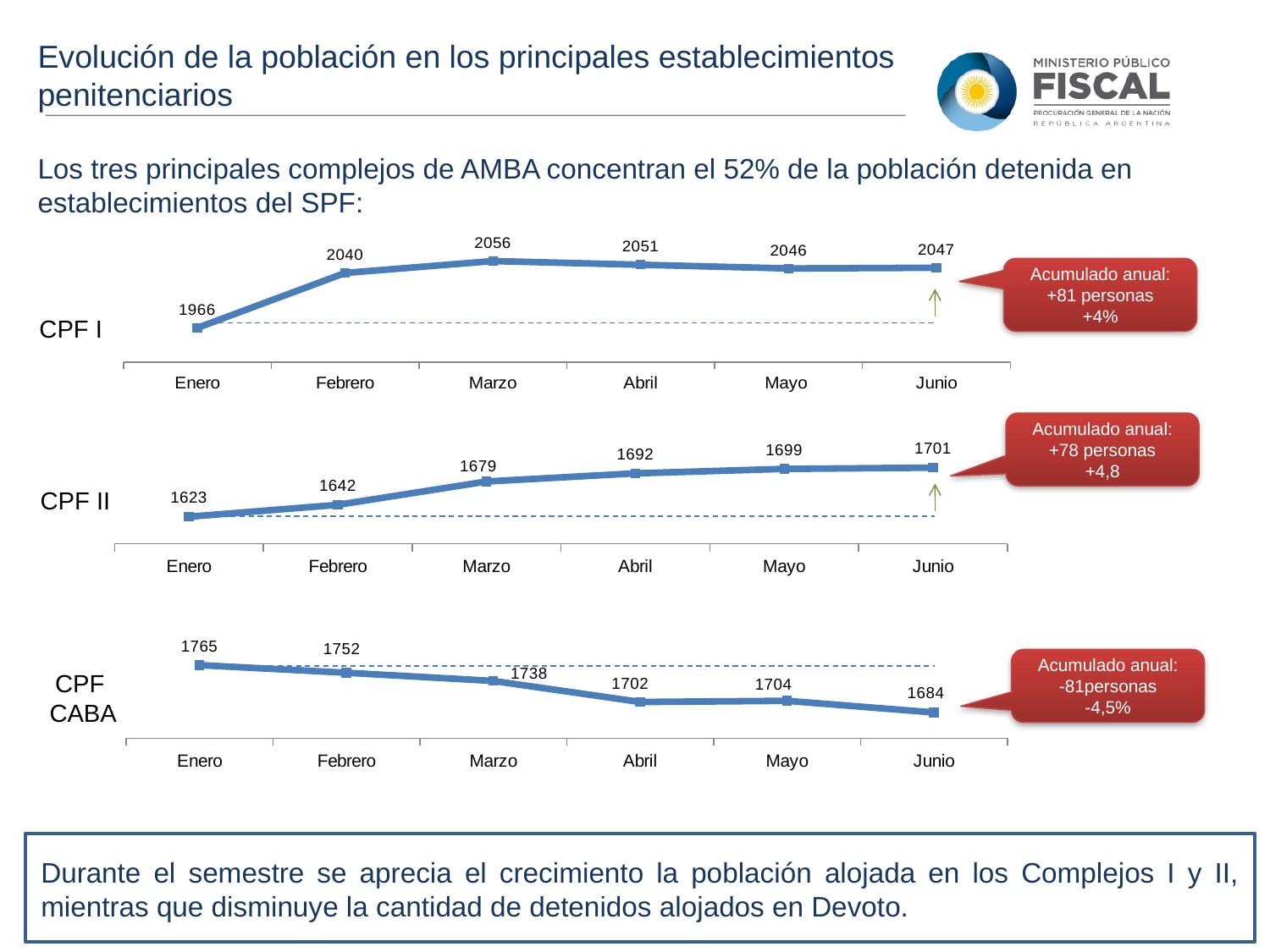
In the CPF CABA chart, do the values generally rise or fall from Enero to Junio? Fall In the CPF I chart, what is the value for Marzo? 2056 In the CPF II chart, what is the value for Enero? 1623 In the CPF I chart, what is the difference between the values for Febrero and Enero? 74 What kind of chart is the CPF CABA chart? Line chart In the CPF II chart, which month has the lowest value? Enero In the CPF I chart, which month has the highest value? Marzo In the CPF CABA chart, which month has the highest value? Enero In the CPF CABA chart, what is the difference between the values for Enero and Junio? 81 In the CPF II chart, which is larger, the value for Marzo or the value for Febrero? Marzo In the CPF CABA chart, what is the value for Junio? 1684 How many months are plotted in the CPF II chart? 6